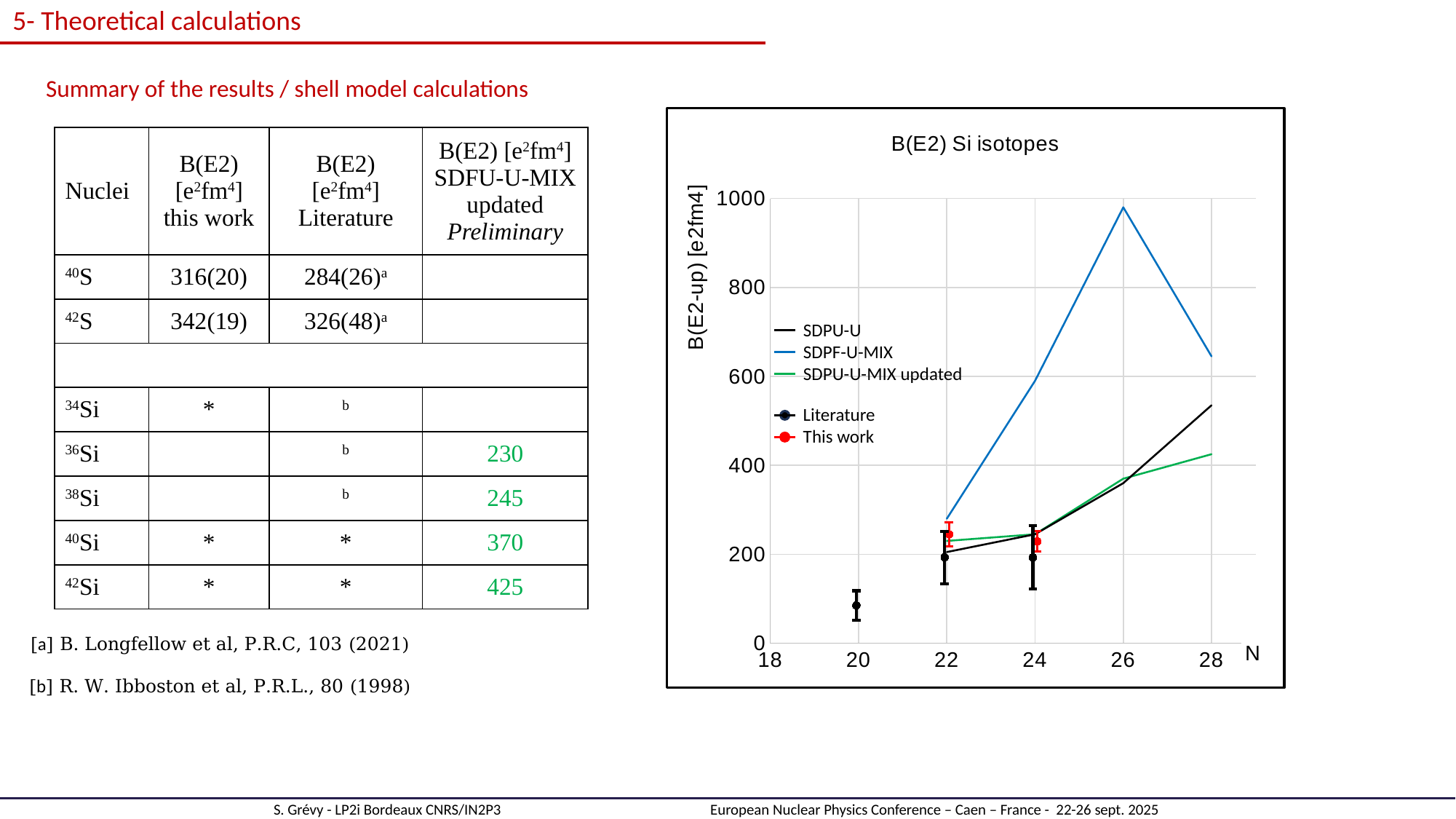
What is the label of the y axis of the "B(E2) Si isotopes" chart? B(E2-up) [e2fm4] How many series does the legend of the "B(E2) Si isotopes" chart list? 5 What is the title of the chart on the slide? B(E2) Si isotopes In the "B(E2) Si isotopes" chart, is the SDPF-U-MIX value at N = 26 greater or less than 800? greater In the "B(E2) Si isotopes" chart, which series reaches the highest value? SDPF-U-MIX In the "B(E2) Si isotopes" chart, is the SDPU-U value at N = 28 greater or less than 400? greater In the "B(E2) Si isotopes" chart, at N = 28, which is larger: SDPU-U or SDPU-U-MIX updated? SDPU-U In the "B(E2) Si isotopes" chart, how many Literature data points are plotted? 3 In the "B(E2) Si isotopes" chart, does the SDPU-U line rise or fall from N = 22 to N = 28? rise What kind of chart is the "B(E2) Si isotopes" chart? line chart In the "B(E2) Si isotopes" chart, at which value of N does the SDPF-U-MIX line reach its peak? 26 In the "B(E2) Si isotopes" chart, is the Literature value at N = 20 greater or less than 200? less